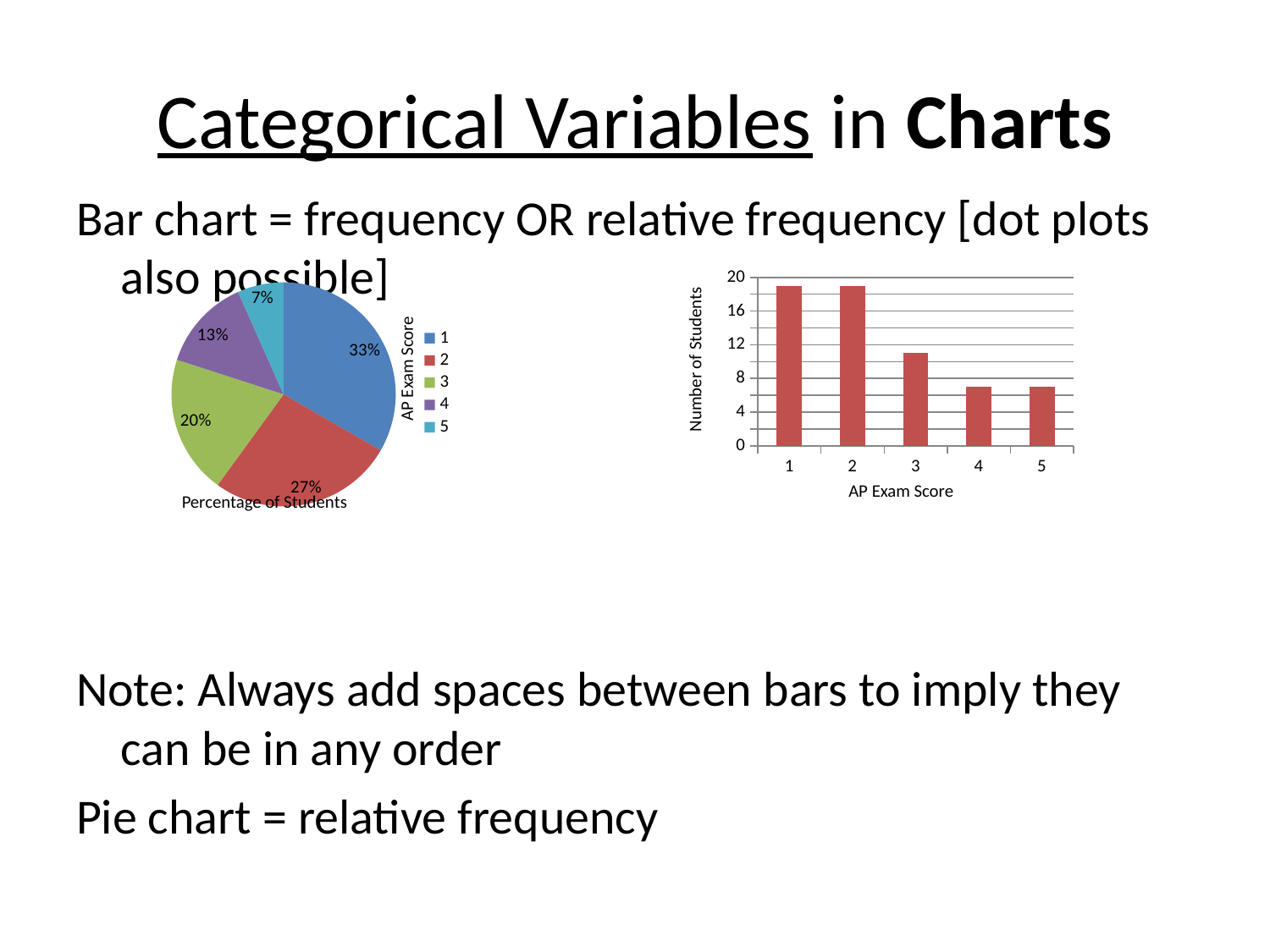
In the bar chart on the right, what is the label of the y axis? Number of Students In the pie chart on the left, what percentage of students is shown for AP Exam Score 3? 20% In the pie chart on the left, what percentage of students is shown for AP Exam Score 1? 33% In the pie chart on the left, what is the difference in percentage points between the slices for AP Exam Score 2 and AP Exam Score 4? 14 What type of chart is the chart on the right of the slide? bar chart In the bar chart on the right, how many AP Exam Score categories are shown on the x axis? 5 In the pie chart on the left, what percentage of students is shown for AP Exam Score 5? 7% In the bar chart on the right, is the number of students for AP Exam Score 4 greater or less than 8? less In the pie chart on the left, how many entries does the legend list? 5 In the pie chart on the left, which AP Exam Score has the smallest slice? 5 In the bar chart on the right, is the number of students for AP Exam Score 1 greater or less than 16? greater In the pie chart on the left, which AP Exam Score has the largest slice? 1